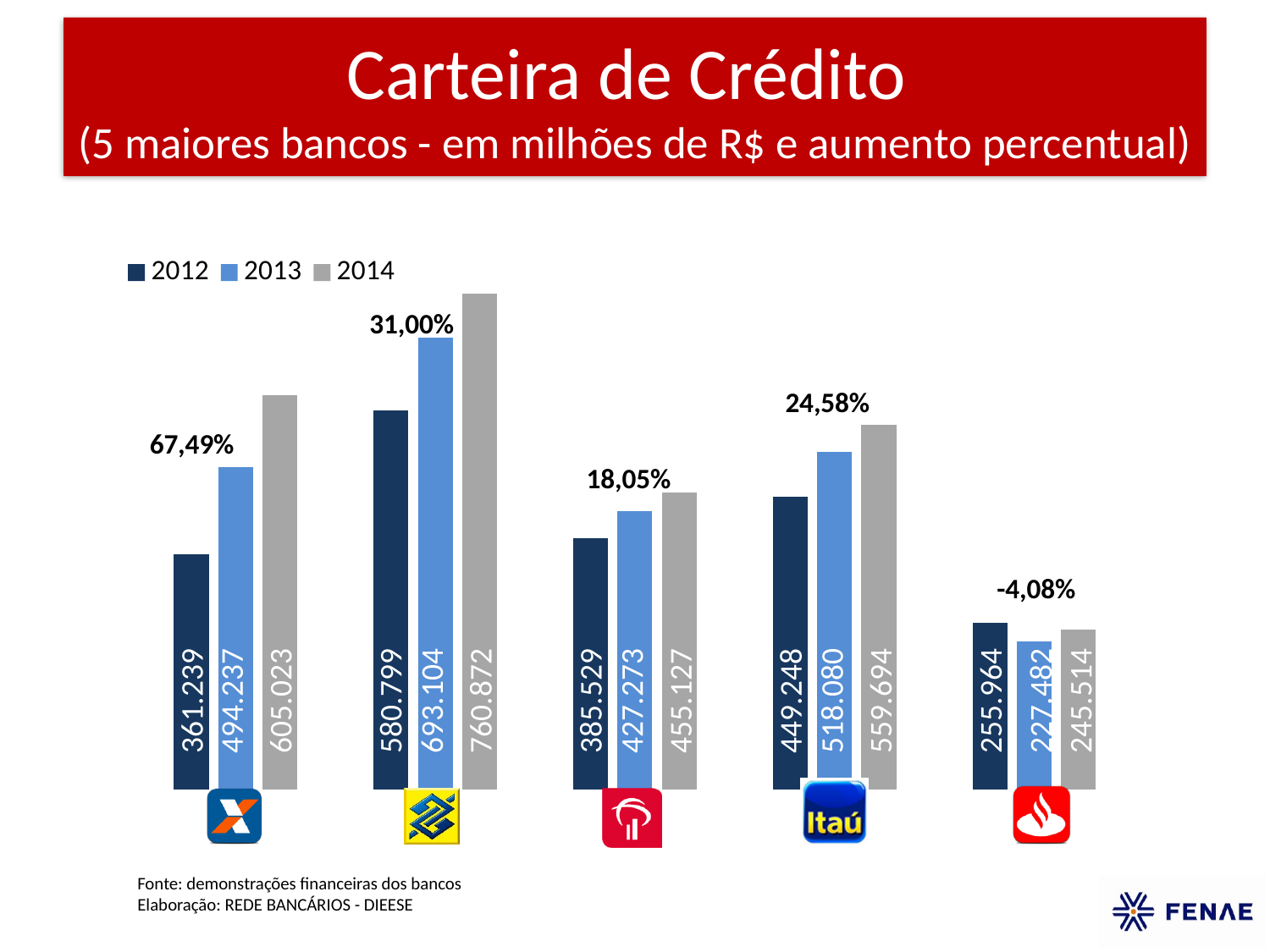
Which has the larger 2013 value: Itaú or the third bank group from the left? Itaú What percentage change is shown above the rightmost bank group? -4,08% How many bank groups are plotted in the chart? 5 What percentage increase is shown above the Itaú group? 24,58% Do the values for Itaú rise or fall from 2012 to 2014? rise What is the lowest 2012 value shown in the chart? 255.964 What is the 2014 value for Itaú? 559.694 What is the 2012 value for Itaú? 449.248 What kind of chart is shown on the slide? bar chart What is the highest 2014 value shown in the chart? 760.872 What is the difference between the 2014 and 2012 values for Itaú? 110.446 How many series does the legend list? 3